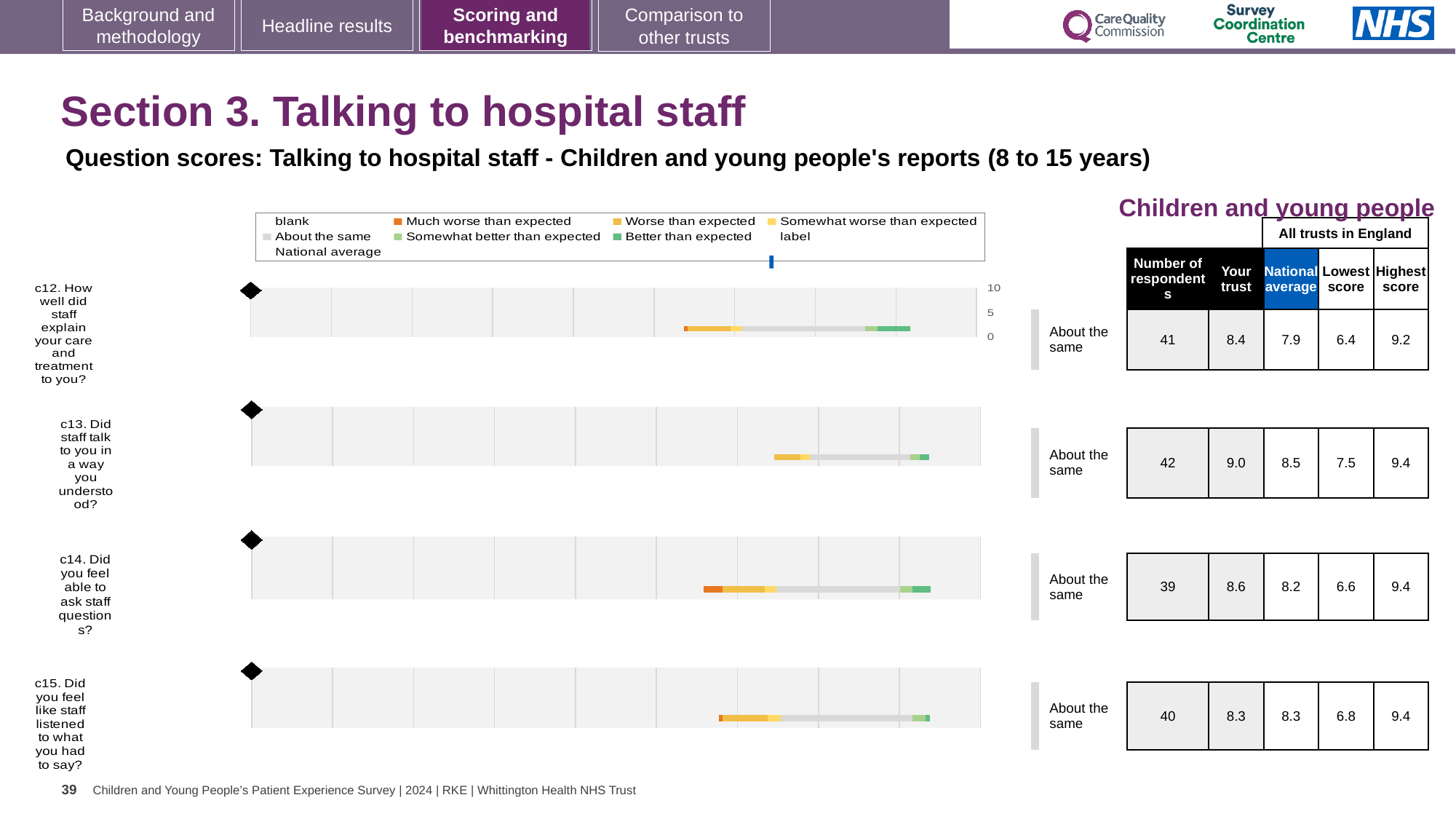
What is the highest tick value shown on the axis of the c12 chart? 10 In the table next to the c13 chart, what is the national average for c13 (Did staff talk to you in a way you understood?)? 8.5 Which of the four questions (c12 to c15) has the highest 'Your trust' score in the table? c13 How many entries does the legend above the charts list? 9 In the table next to the c12 chart, what is the 'Your trust' score for c12 (How well did staff explain your care and treatment to you?)? 8.4 What kind of chart is used for the c12 to c15 question scores on this slide? bar chart What colour does the legend use for 'Much worse than expected'? orange Which of the four questions (c12 to c15) has the lowest 'Your trust' score in the table? c15 In the table next to the c14 chart, how many respondents are listed for c14 (Did you feel able to ask staff questions?)? 39 How many question charts (c12 to c15) are shown on the slide? 4 What is the difference between the 'Your trust' score and the national average for c13 in the table? 0.5 In the table next to the c15 chart, what is the lowest score across all trusts in England for c15 (Did you feel like staff listened to what you had to say?)? 6.8